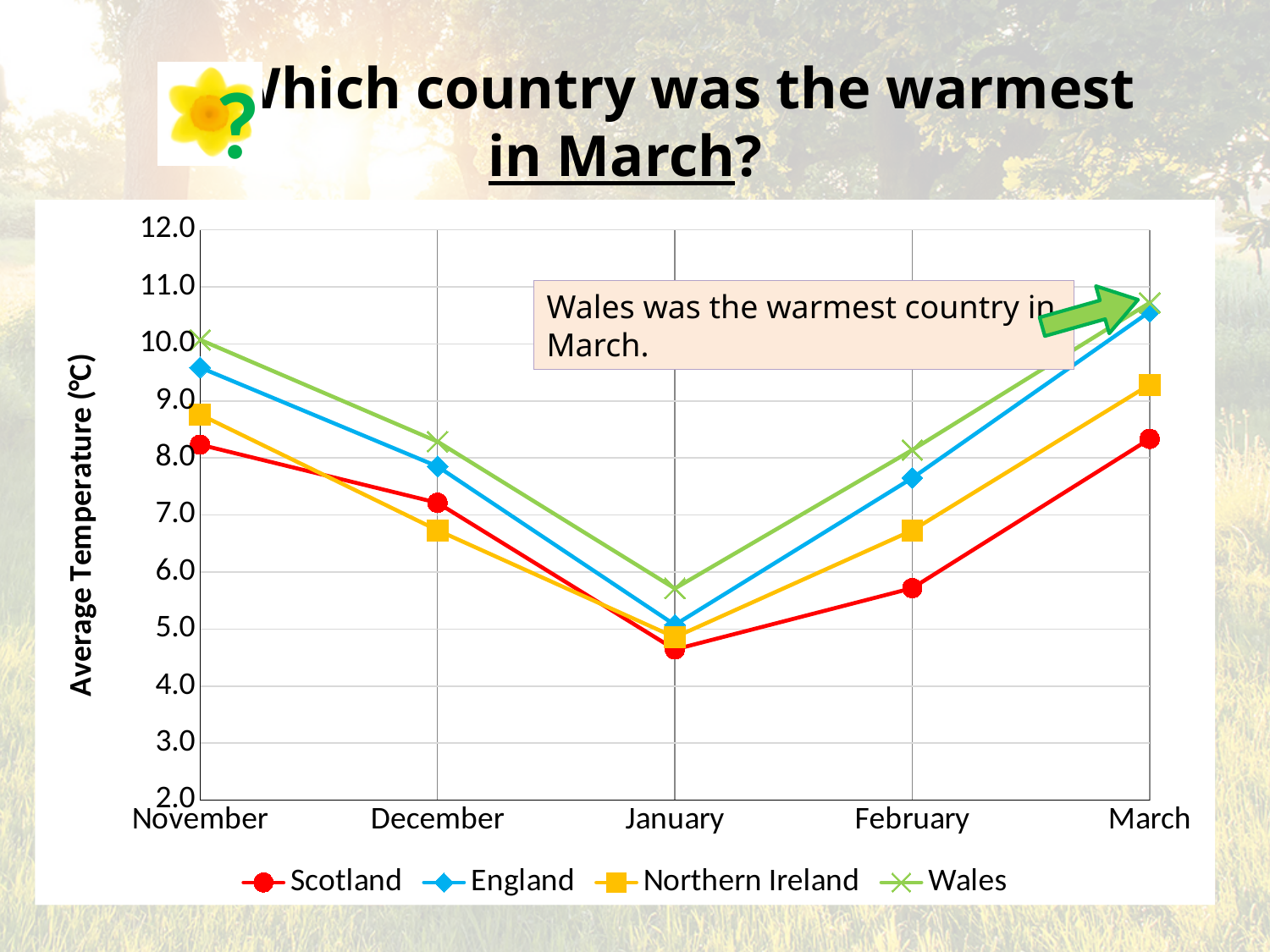
Which country had the lowest average temperature in February? Scotland Is the value for England in January greater or less than 6.0? less What is the title of the y axis? Average Temperature (°C) Which country was the warmest in March? Wales How many months are shown along the x axis? 5 In which month was Scotland's average temperature lowest? January Is the value for Scotland in February greater or less than 6.0? less How many series does the legend list? 4 In February, which had the higher average temperature, Scotland or Northern Ireland? Northern Ireland Is the value for Wales in November greater or less than 9.0? greater Do the average temperatures rise or fall from November to January? fall What kind of chart is shown on the slide? line chart